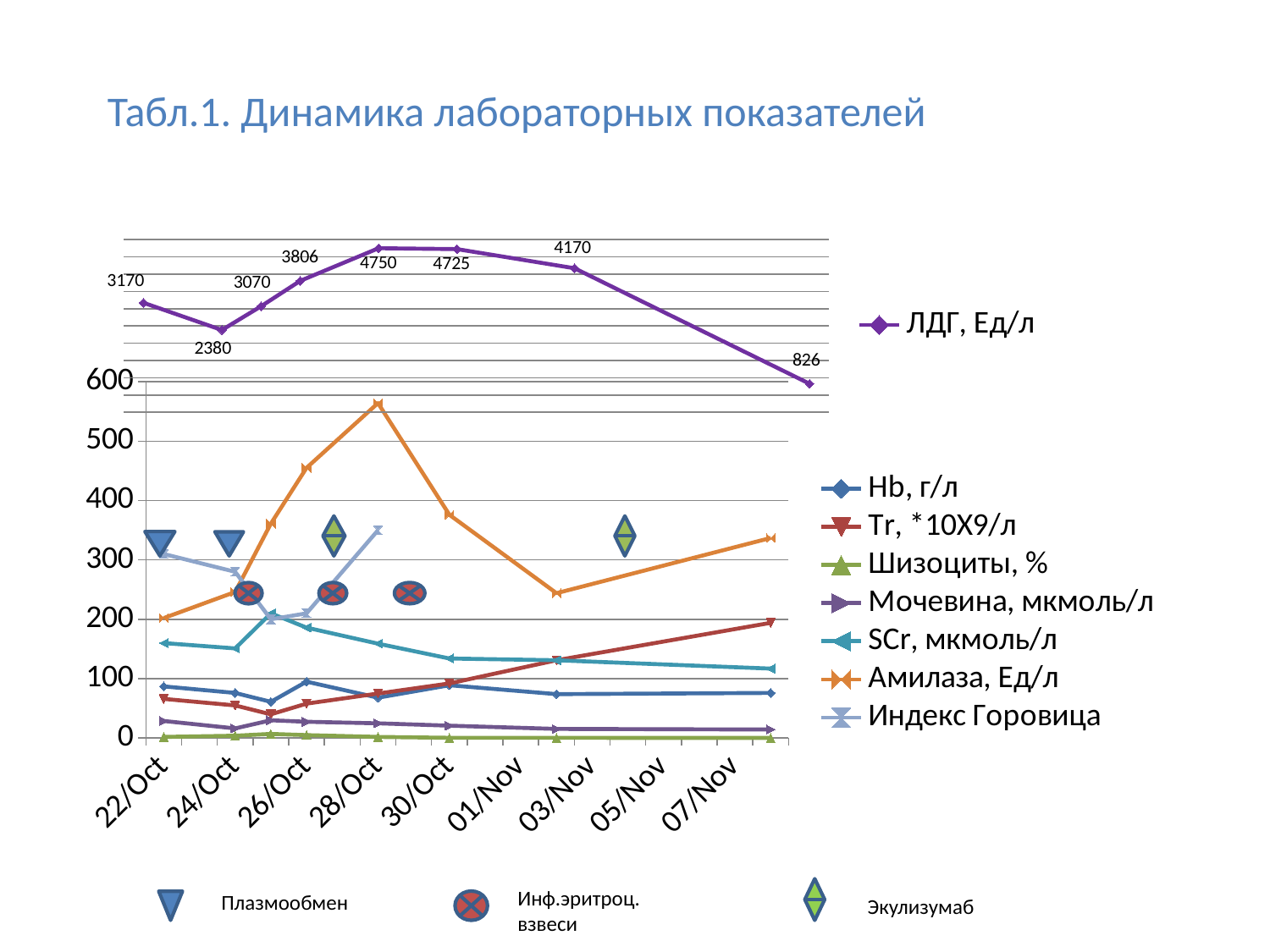
What type of chart is the top chart (ЛДГ, Ед/л)? line chart On the bottom chart, is the value of Hb, г/л at 22/Oct greater or less than 100? less On the bottom chart, is the peak value of Амилаза, Ед/л (around 28/Oct) greater or less than 500? greater On the top chart (ЛДГ, Ед/л), what is the difference between the first value (3170) and the second value (2380)? 790 On the bottom chart, how many series does the legend list? 7 On the top chart (ЛДГ, Ед/л), what is the value of the last data point? 826 On the top chart (ЛДГ, Ед/л), what is the highest value shown? 4750 On the top chart (ЛДГ, Ед/л), what is the difference between the highest value (4750) and the lowest value (826)? 3924 On the top chart (ЛДГ, Ед/л), what is the lowest value shown? 826 On the top chart (ЛДГ, Ед/л), which is larger: the value labelled 4725 or the value labelled 4170? 4725 On the top chart (ЛДГ, Ед/л), how many data points are plotted? 8 On the top chart (ЛДГ, Ед/л), what is the value of the first data point? 3170